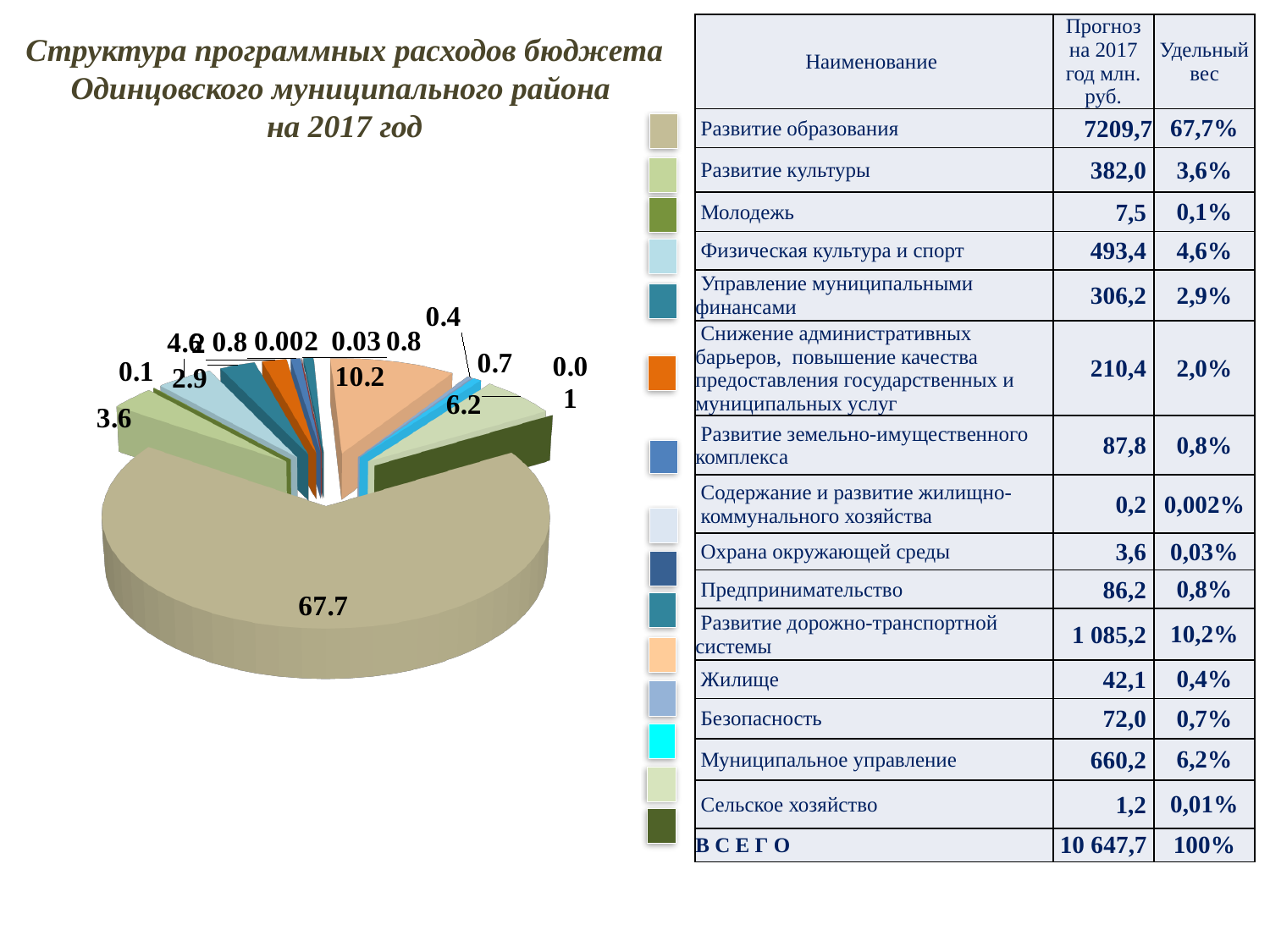
According to the table, what is the total (ВСЕГО) of programme expenditures in million rubles? 10 647,7 Which category does the largest slice of the pie chart represent? Развитие образования What is the data label on the largest slice of the pie chart? 67.7 What is the smallest data label shown on the pie chart? 0.002 How many categories are listed in the table that serves as the pie chart's legend (excluding the total row)? 15 What kind of chart is shown on the slide? pie chart According to the table, what is the forecast value for Развитие образования in million rubles? 7209,7 What is the difference between the pie chart's largest slice label (67.7) and the 10.2 slice label? 57.5 What data label does the pie chart show for the slice representing Развитие дорожно-транспортной системы? 10.2 What data label does the pie chart show for the slice representing Муниципальное управление? 6.2 What is the title of the slide's chart? Структура программных расходов бюджета Одинцовского муниципального района на 2017 год Which slice is larger: the one labelled 10.2 or the one labelled 6.2? 10.2